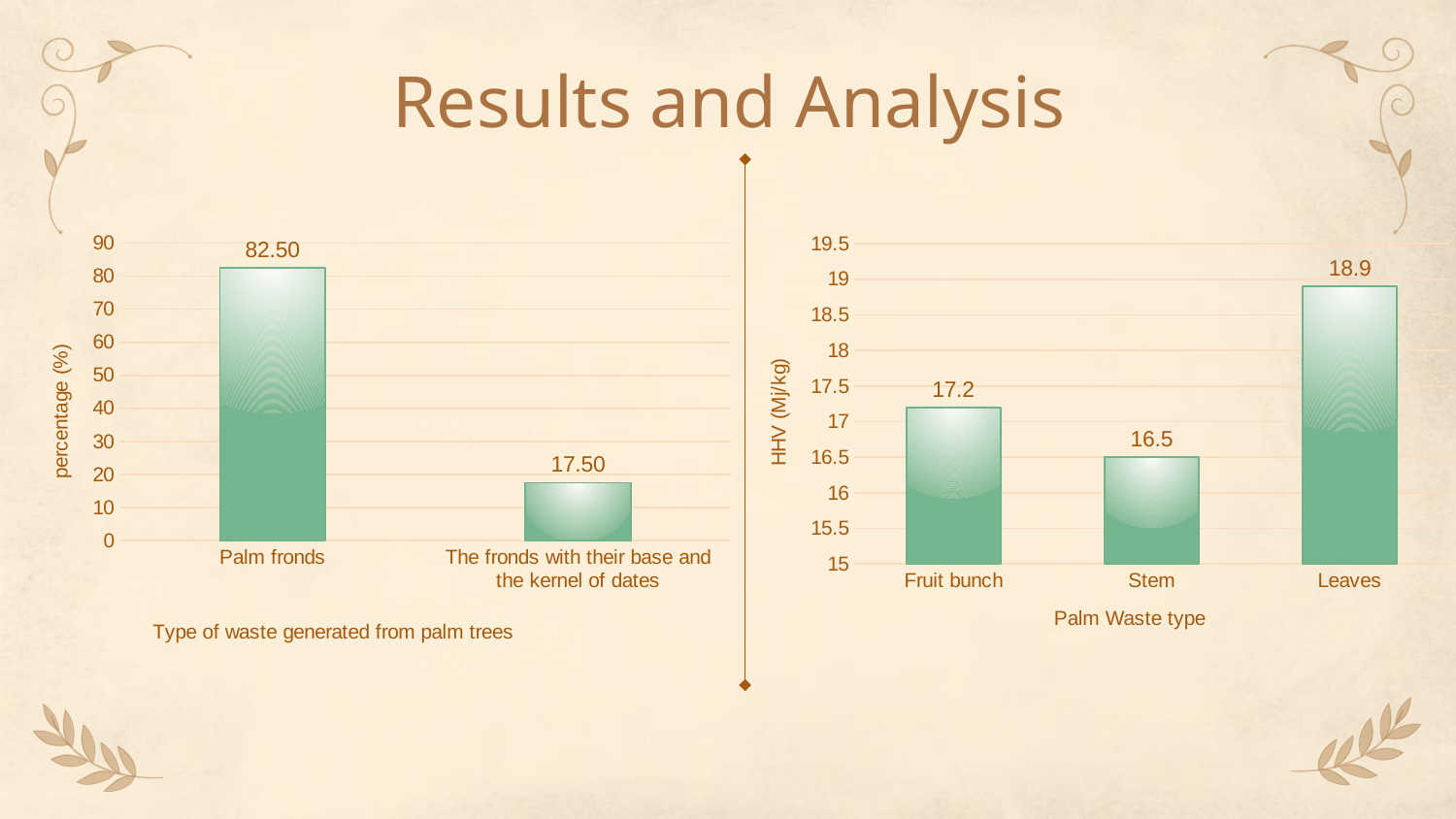
In the right chart (Palm Waste type), what is the HHV (Mj/kg) for Stem? 16.5 In the right chart (Palm Waste type), what is the difference in HHV between Leaves and Fruit bunch? 1.7 In the left chart (Type of waste generated from palm trees), which category has the higher percentage? Palm fronds In the right chart (Palm Waste type), is the HHV for Fruit bunch greater or less than Stem? greater In the left chart (Type of waste generated from palm trees), what is the percentage for Palm fronds? 82.50 In the left chart (Type of waste generated from palm trees), what kind of chart is it? Bar chart In the left chart (Type of waste generated from palm trees), what is the percentage for The fronds with their base and the kernel of dates? 17.50 In the left chart (Type of waste generated from palm trees), how many categories are shown? 2 In the right chart (Palm Waste type), what is the HHV (Mj/kg) for Leaves? 18.9 In the right chart (Palm Waste type), what is the label of the y axis? HHV (Mj/kg) In the left chart (Type of waste generated from palm trees), what is the difference between the Palm fronds value and the value for The fronds with their base and the kernel of dates? 65.00 In the right chart (Palm Waste type), which palm waste type has the lowest HHV? Stem